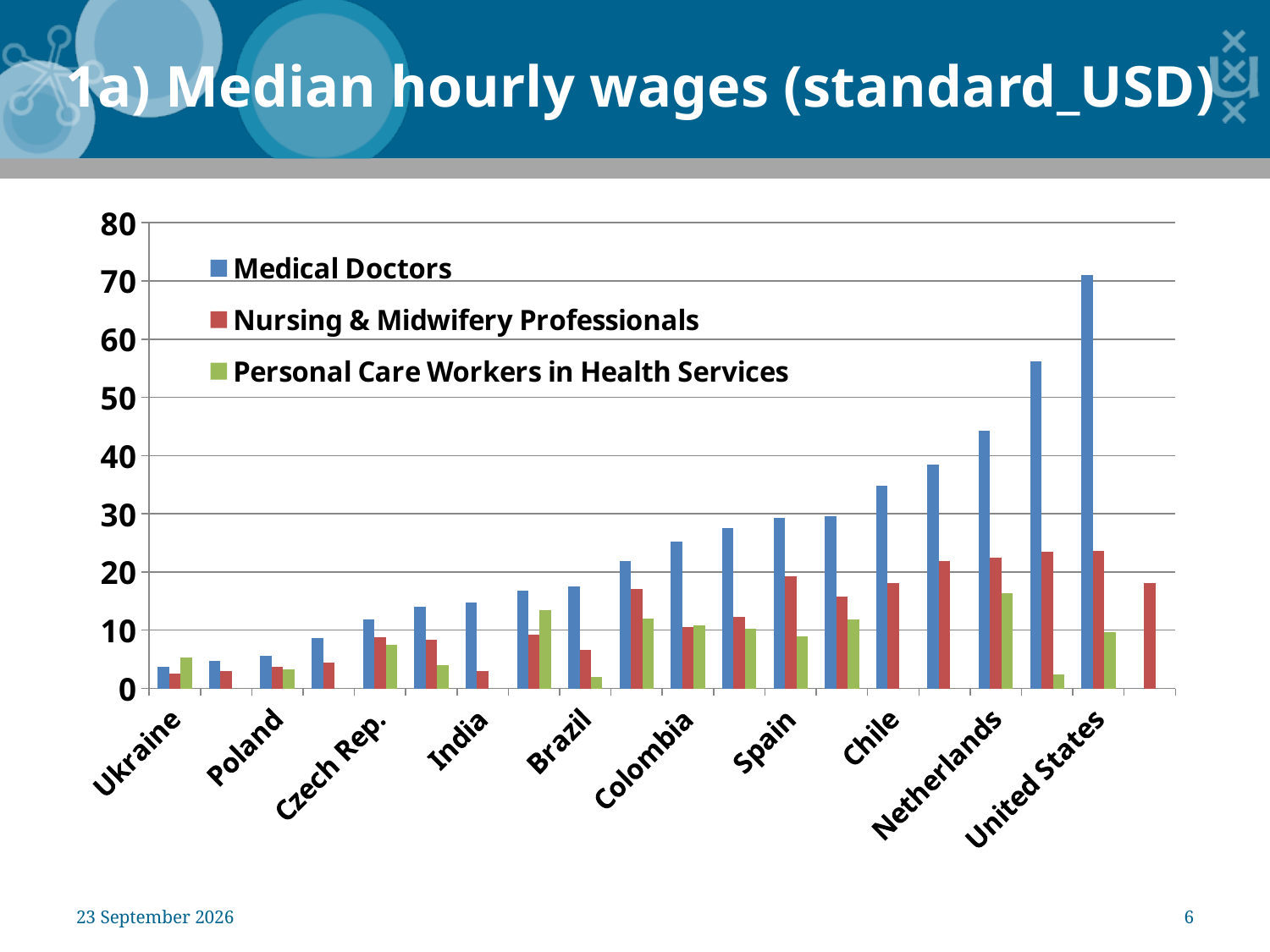
Is the Medical Doctors value for Ukraine greater or less than 10? less Is the Nursing & Midwifery Professionals value for the United States greater or less than 20? greater Is the Medical Doctors value for the United States greater or less than 60? greater What kind of chart is shown on the slide? bar chart How many series does the legend list? 3 Which series is shown in green? Personal Care Workers in Health Services Which series is shown in blue? Medical Doctors Which country has the highest Medical Doctors value? United States Do the Medical Doctors values rise or fall from left to right along the x axis? rise In the United States, which is larger: the Medical Doctors value or the Nursing & Midwifery Professionals value? Medical Doctors